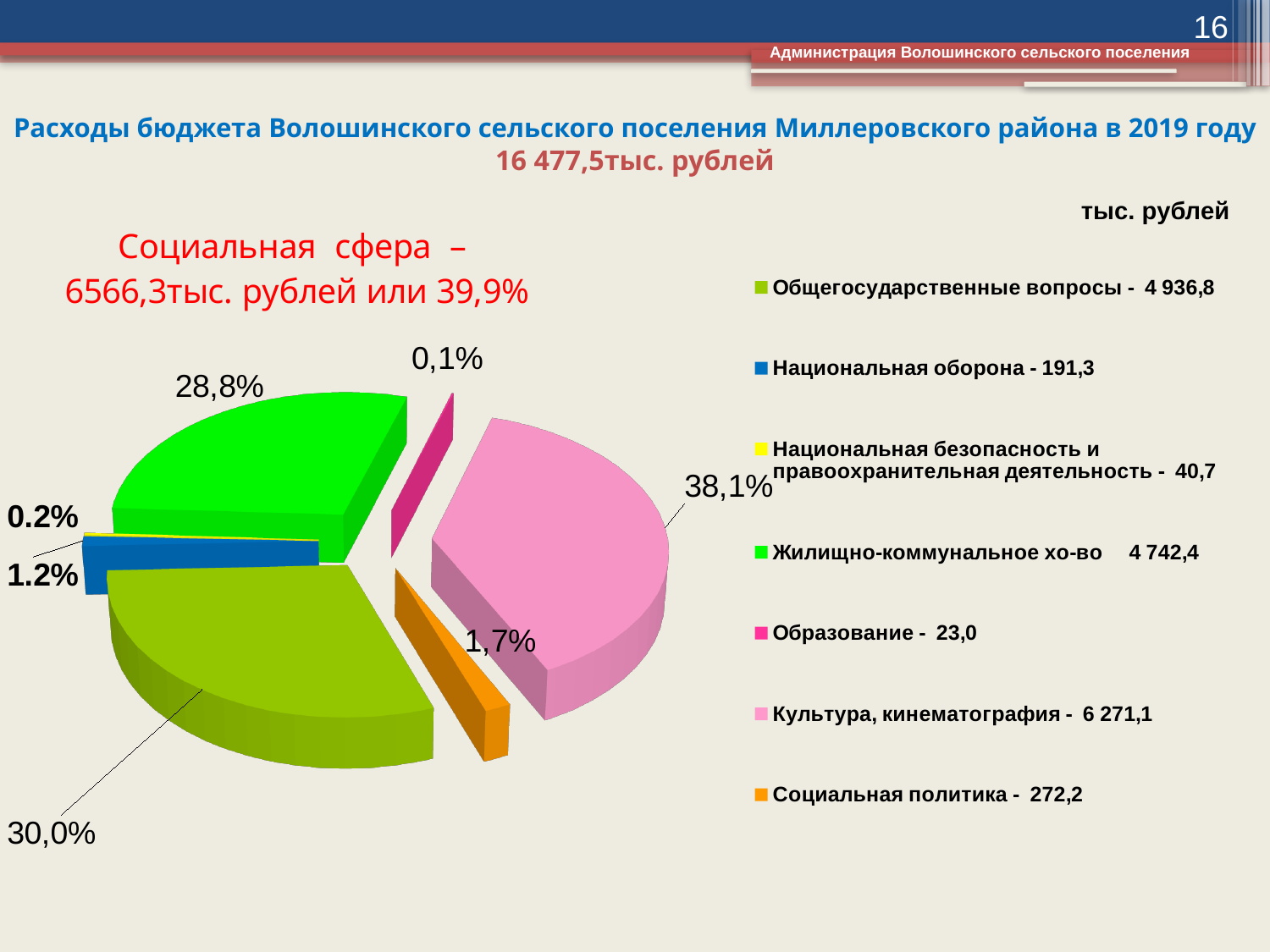
What is the value for Социальная политика in the legend? 272,2 What share of the pie does the Культура, кинематография slice represent? 38,1% What is the difference between the values for Общегосударственные вопросы and Жилищно-коммунальное хо-во? 194,4 What kind of chart is shown on the slide? pie chart What unit is stated for the values in the legend? тыс. рублей Which is larger, the value for Национальная оборона or the value for Социальная политика? Социальная политика What is the value for Культура, кинематография in the legend? 6 271,1 What is the value for Общегосударственные вопросы in the legend? 4 936,8 Which category has the smallest value? Образование How many categories does the legend of the pie chart list? 7 Which category has the largest value? Культура, кинематография What share of the pie does the Жилищно-коммунальное хо-во slice represent? 28,8%